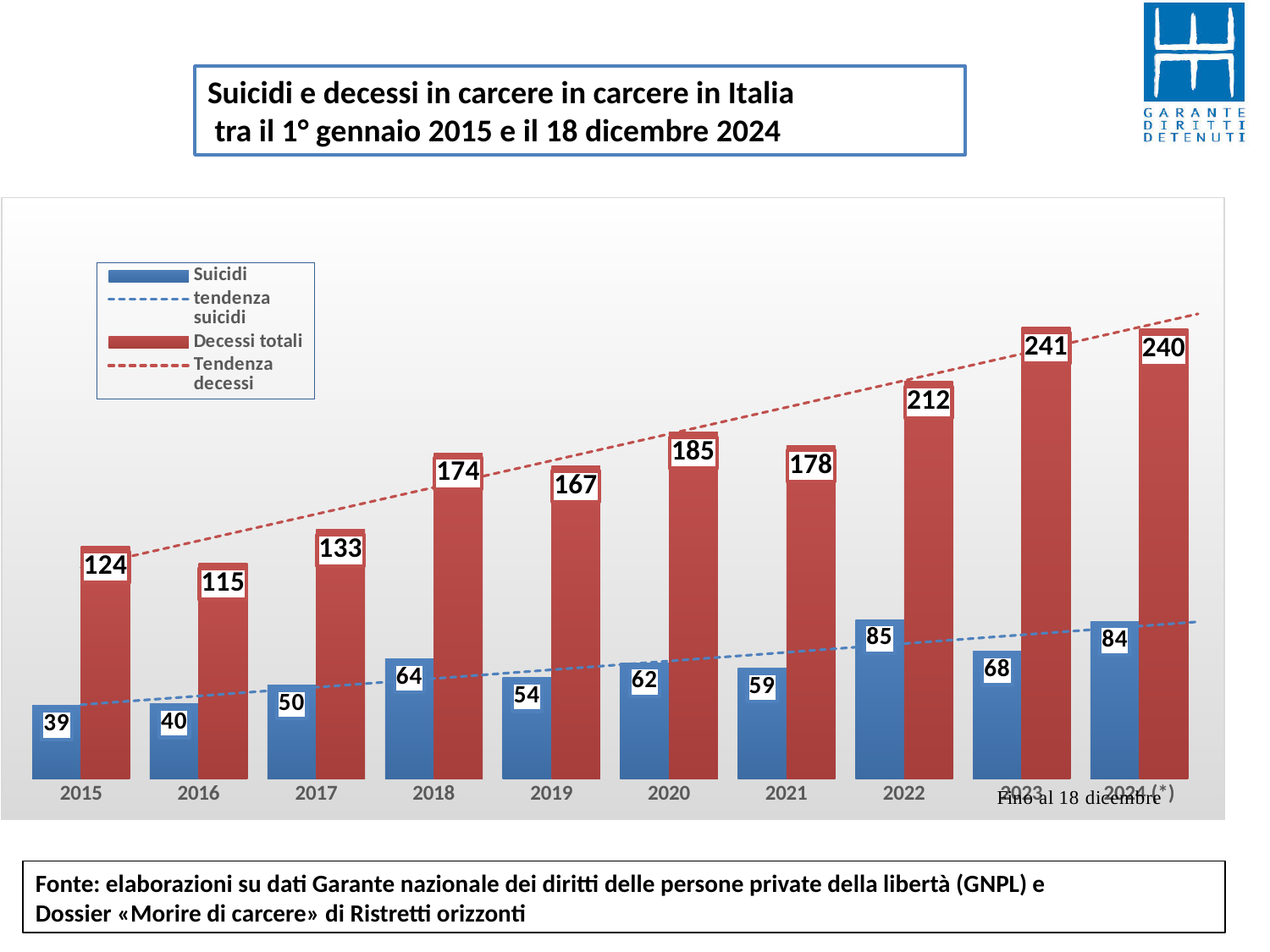
How many years are shown on the x axis? 10 Which year has the highest value for Decessi totali? 2023 What is the value of Decessi totali for 2020? 185 What is the difference between Decessi totali and Suicidi in 2024 (*)? 156 What is the difference between Decessi totali in 2023 and Decessi totali in 2015? 117 What is the value of Suicidi for 2022? 85 How many entries does the legend list? 4 What is the value of Suicidi for 2018? 64 What kind of chart is shown on the slide? Bar chart Which year has the lowest value for Suicidi? 2015 Which is larger, Suicidi in 2019 or Suicidi in 2020? Suicidi in 2020 Which year has the lowest value for Decessi totali? 2016